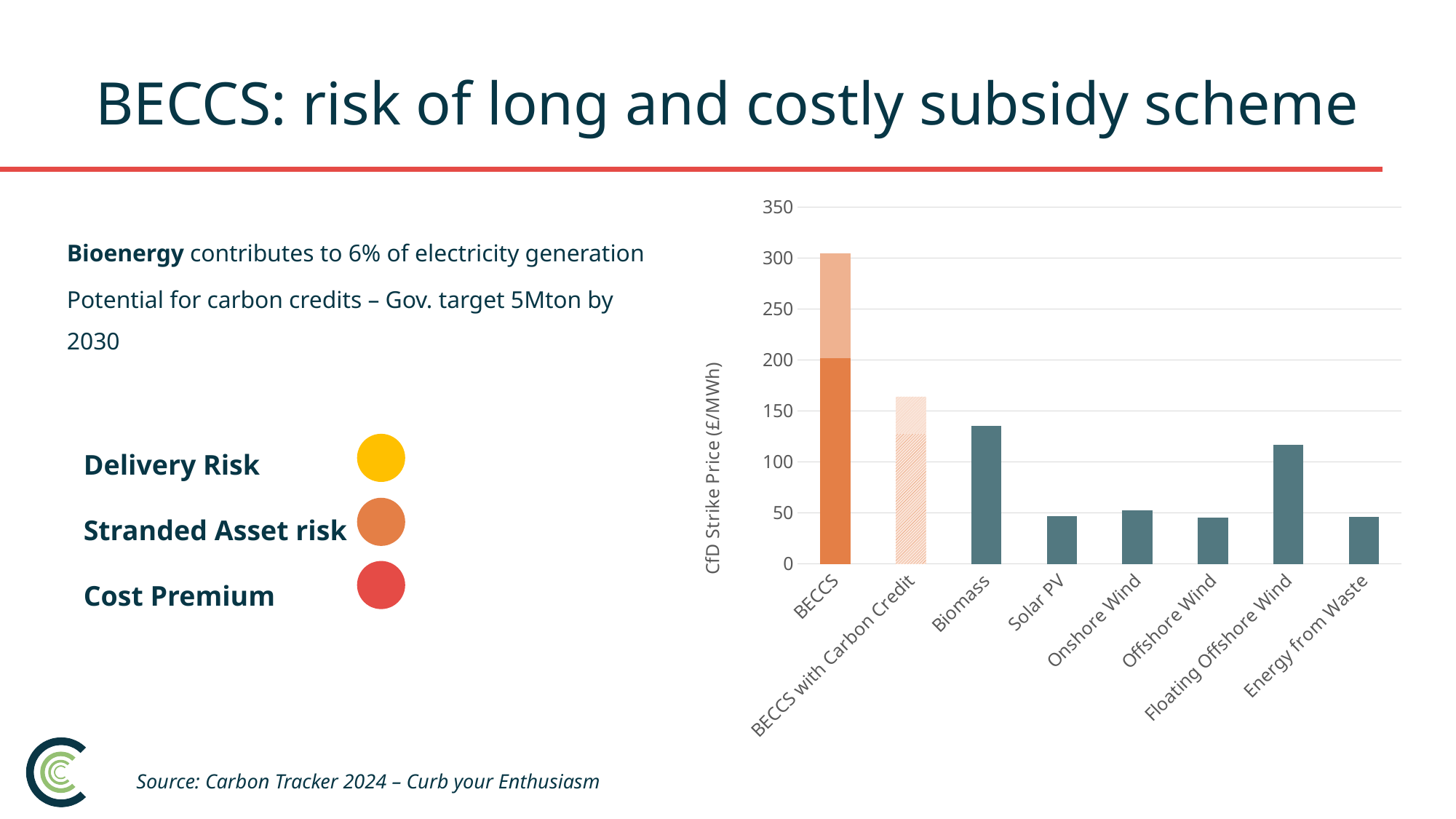
Which category has the highest CfD strike price in the chart? BECCS Is the value for Offshore Wind greater or less than 100? less What is the label of the vertical axis of the chart? CfD Strike Price (£/MWh) What kind of chart is shown on the slide? bar chart Which has a higher CfD strike price, Biomass or Floating Offshore Wind? Biomass Which has a higher CfD strike price, BECCS or Biomass? BECCS Is the value for Floating Offshore Wind greater or less than 100? greater Which has a higher CfD strike price, Floating Offshore Wind or Onshore Wind? Floating Offshore Wind Is the value for Biomass greater or less than 150? less How many categories are shown on the x axis of the chart? 8